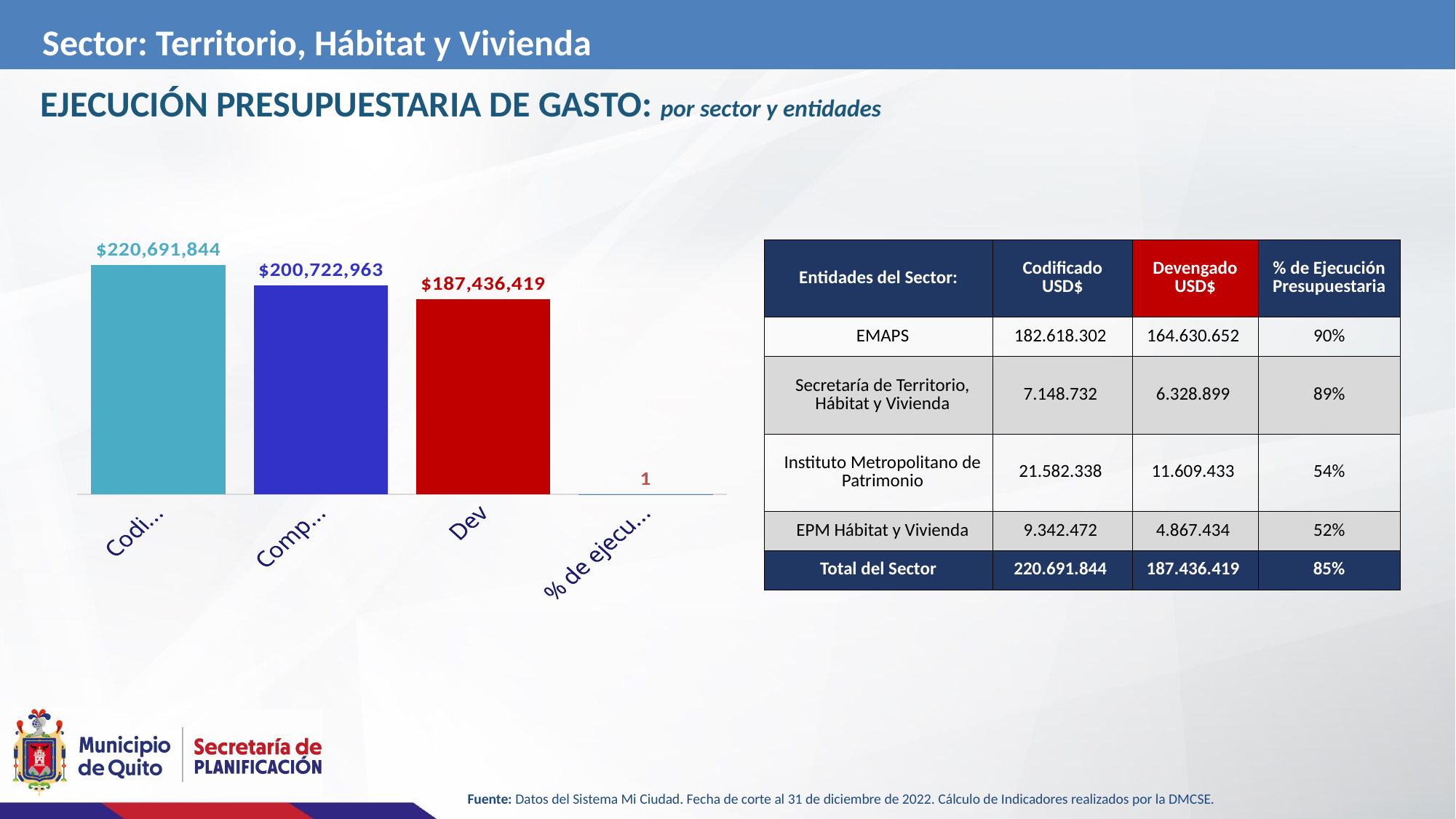
What value is shown for the bar labelled "Dev"? $187,436,419 Which of the three dollar-value bars is the lowest? Dev Which bar has the highest value? Codi... How many categories are shown on the x axis of the chart? 4 What kind of chart is shown on the slide? Bar chart What is the difference between the "Codi..." bar and the "Dev" bar? $33,255,425 What colour is the "Dev" bar? Red What value is shown for the bar labelled "Comp..."? $200,722,963 Which is larger, the "Comp..." bar or the "Dev" bar? Comp... What value is shown for the first bar, labelled "Codi..."? $220,691,844 What data label is shown for the last category, "% de ejecu..."? 1 What is the difference between the "Codi..." bar and the "Comp..." bar? $19,968,881